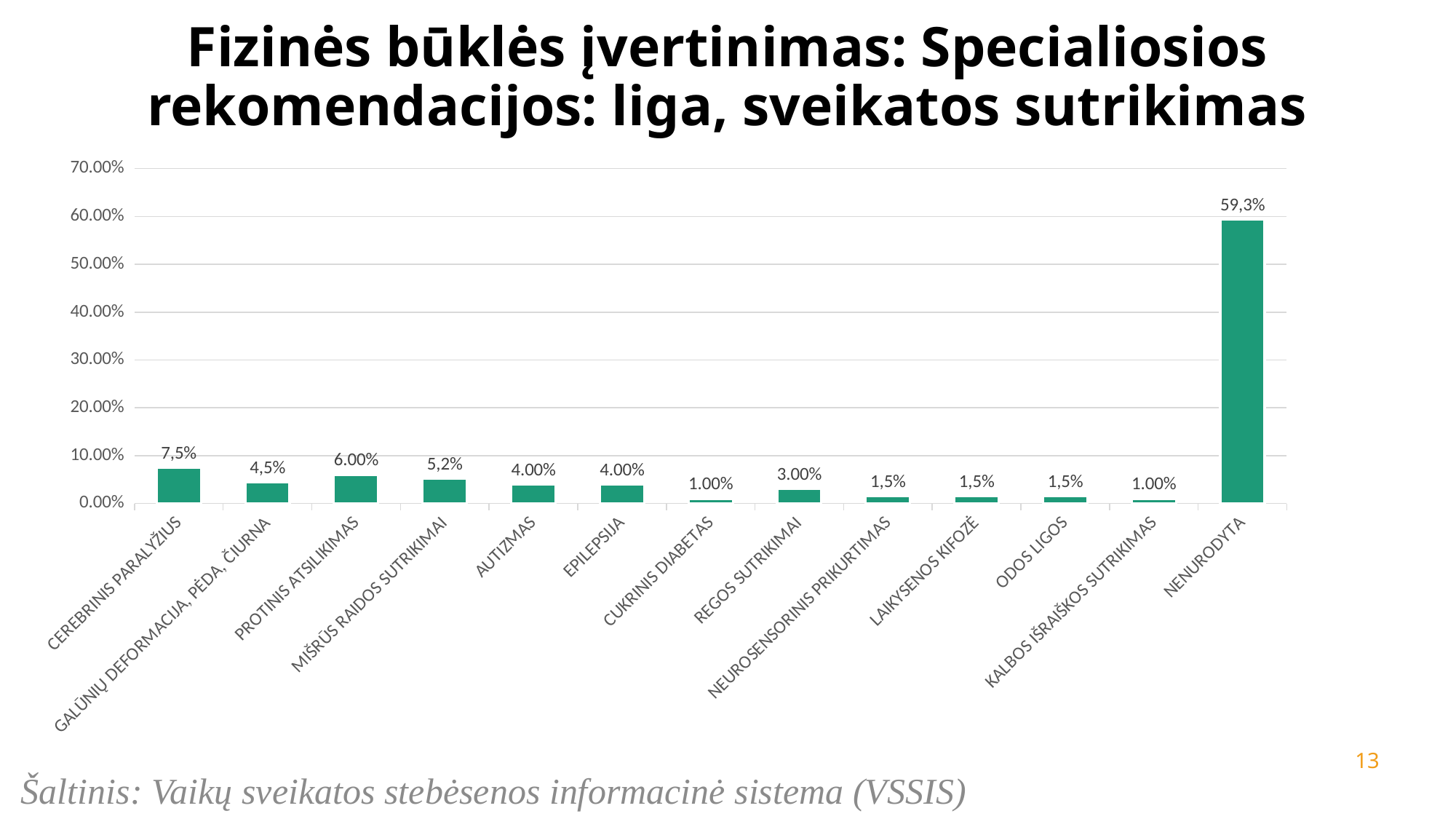
What is the difference between the values for PROTINIS ATSILIKIMAS and AUTIZMAS? 2.00% What is the value for MIŠRŪS RAIDOS SUTRIKIMAI? 5,2% What colour are the bars in the chart? green Which is larger, the value for CEREBRINIS PARALYŽIUS or the value for GALŪNIŲ DEFORMACIJA, PĖDA, ČIURNA? CEREBRINIS PARALYŽIUS What is the value for REGOS SUTRIKIMAI? 3.00% How many categories are shown on the x axis? 13 What is the value for NENURODYTA? 59,3% What is the value for CEREBRINIS PARALYŽIUS? 7,5% What kind of chart is shown on the slide? bar chart What is the difference between the values for NENURODYTA and CEREBRINIS PARALYŽIUS? 51,8% Which category has the highest value? NENURODYTA Is the value for NENURODYTA greater or less than 50.00%? greater